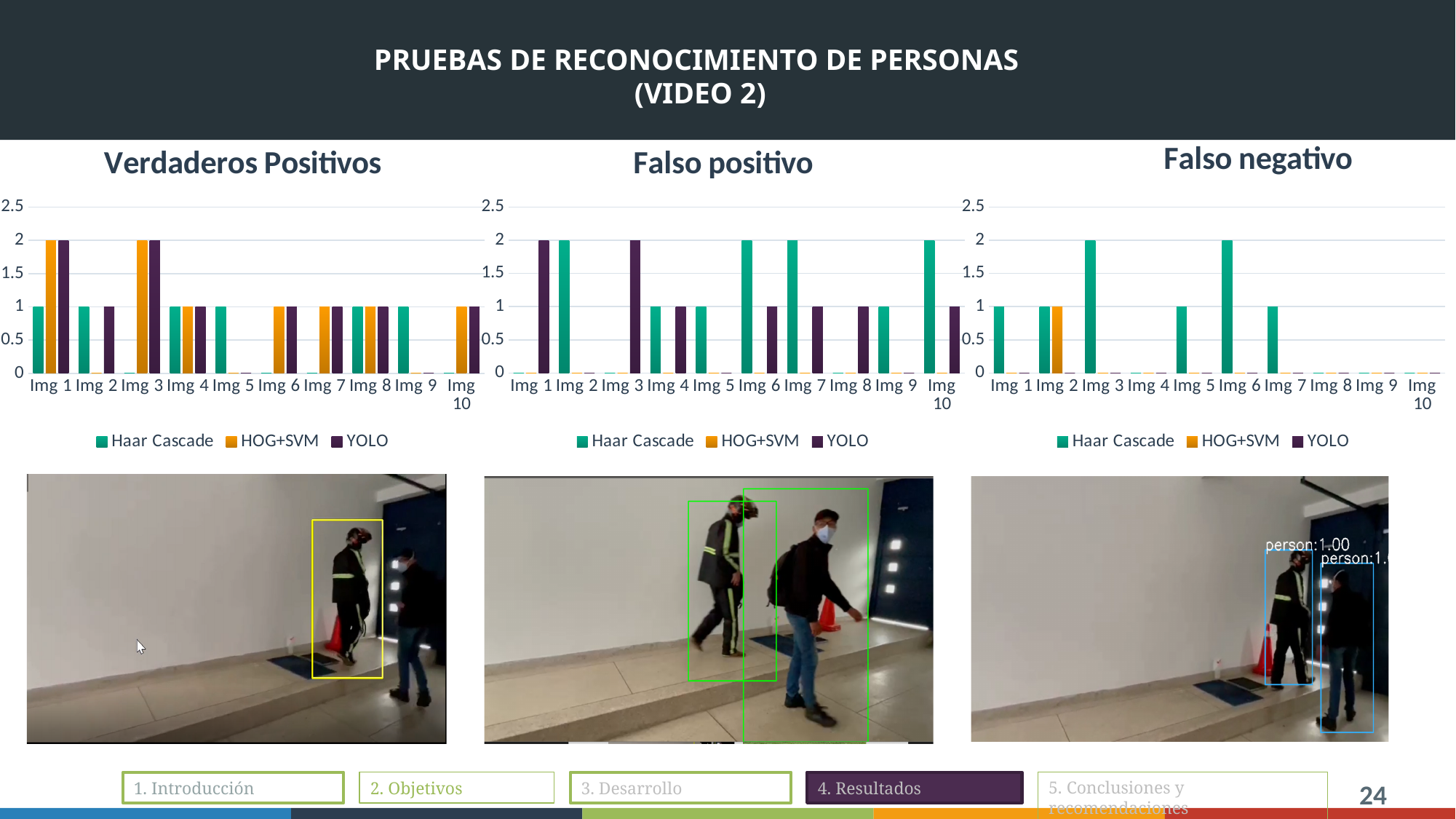
In the "Verdaderos Positivos" chart, what is the difference between HOG+SVM and Haar Cascade at Img 3? 2 How many categories are shown on the x axis of the "Verdaderos Positivos" chart? 10 What kind of chart is the "Falso positivo" chart? Bar chart In the "Falso positivo" chart, what is the value for Haar Cascade at Img 6? 2 In the "Falso positivo" chart, which is larger at Img 7: Haar Cascade or YOLO? Haar Cascade In the "Falso negativo" chart, what is the value for HOG+SVM at Img 2? 1 In the "Falso negativo" chart, what is the value for Haar Cascade at Img 3? 2 In the "Falso positivo" chart, what is the value for YOLO at Img 1? 2 In the "Verdaderos Positivos" chart, what is the value for Haar Cascade at Img 4? 1 How many series does the legend of the "Falso negativo" chart list? 3 In the "Verdaderos Positivos" chart, what is the value for HOG+SVM at Img 1? 2 In the "Falso negativo" chart, which series is shown in purple according to the legend? YOLO